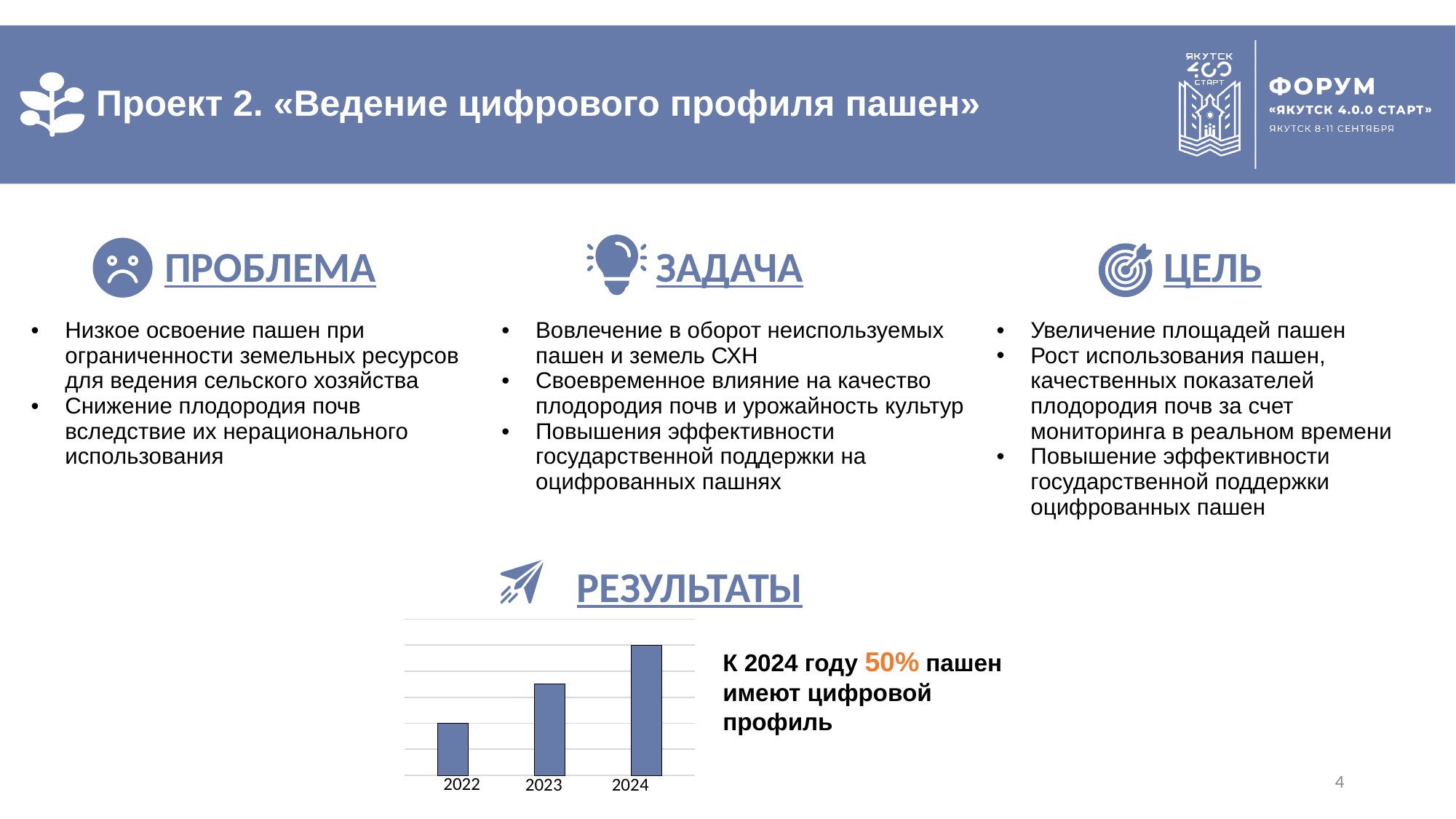
How many bars does the chart under РЕЗУЛЬТАТЫ have? 3 What are the category labels on the x axis of the chart? 2022, 2023, 2024 Which bar is taller, 2023 or 2024? 2024 What kind of chart is shown under the heading РЕЗУЛЬТАТЫ? bar chart What colour are the bars in the chart? blue Which year has the shortest bar in the chart? 2022 Which year has the tallest bar in the chart? 2024 Do the bar heights rise or fall from 2022 to 2024? rise Which year is the first category on the x axis of the chart? 2022 Is the bar for 2023 taller or shorter than the bar for 2022? taller